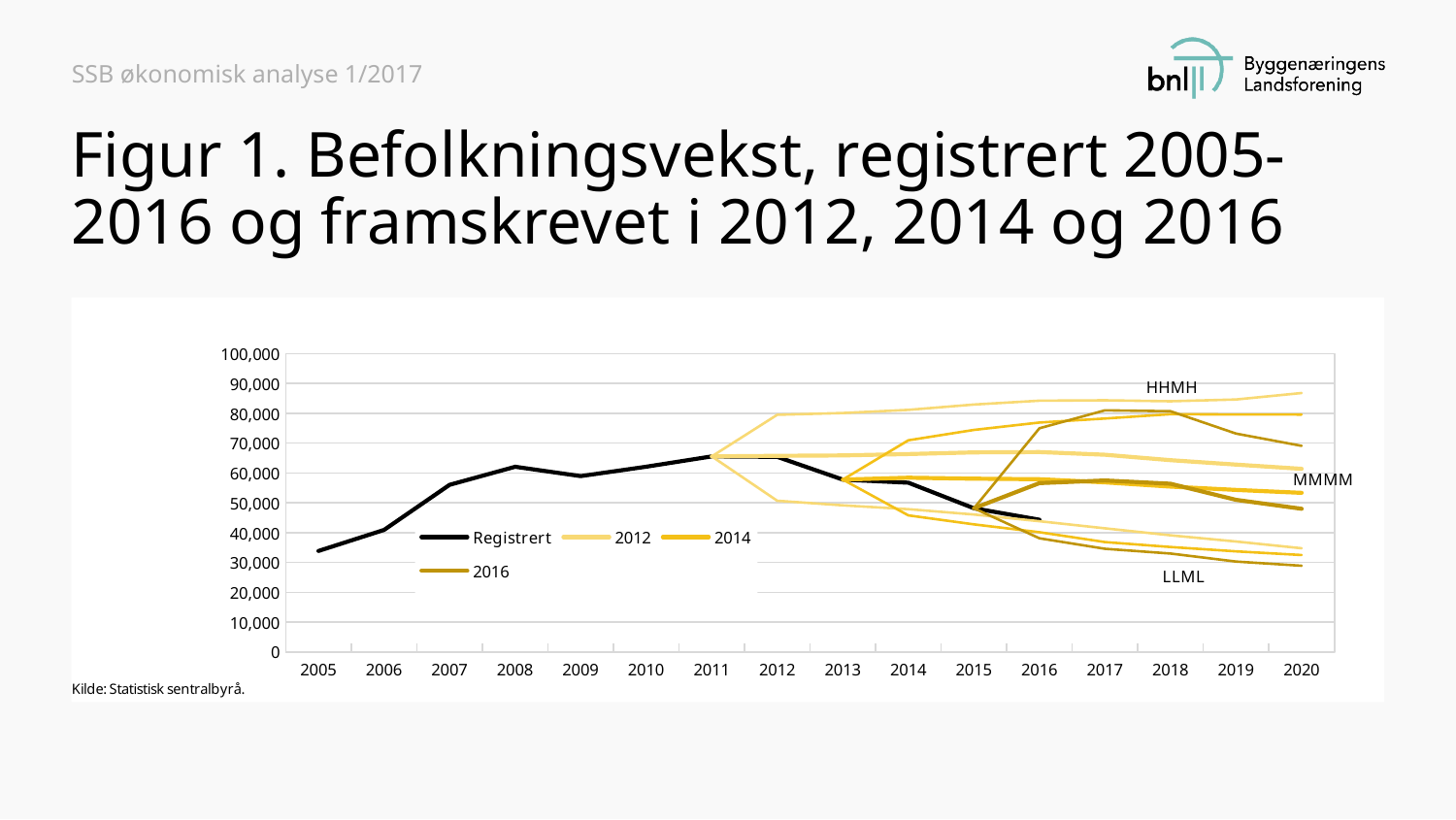
What colour is the Registrert line in the legend? black Is the Registrert value for 2005 greater or less than 40,000? less Does the Registrert series rise or fall between 2012 and 2016? fall Is the Registrert value for 2011 greater or less than 60,000? greater Which is larger, the Registrert value for 2006 or for 2007? 2007 In which year is the Registrert series at its lowest? 2005 What kind of chart is shown on the slide? line chart Is the Registrert value for 2008 greater or less than 60,000? greater Does the Registrert series rise or fall between 2005 and 2011? rise How many series does the legend list? 4 How many years are shown on the x axis? 16